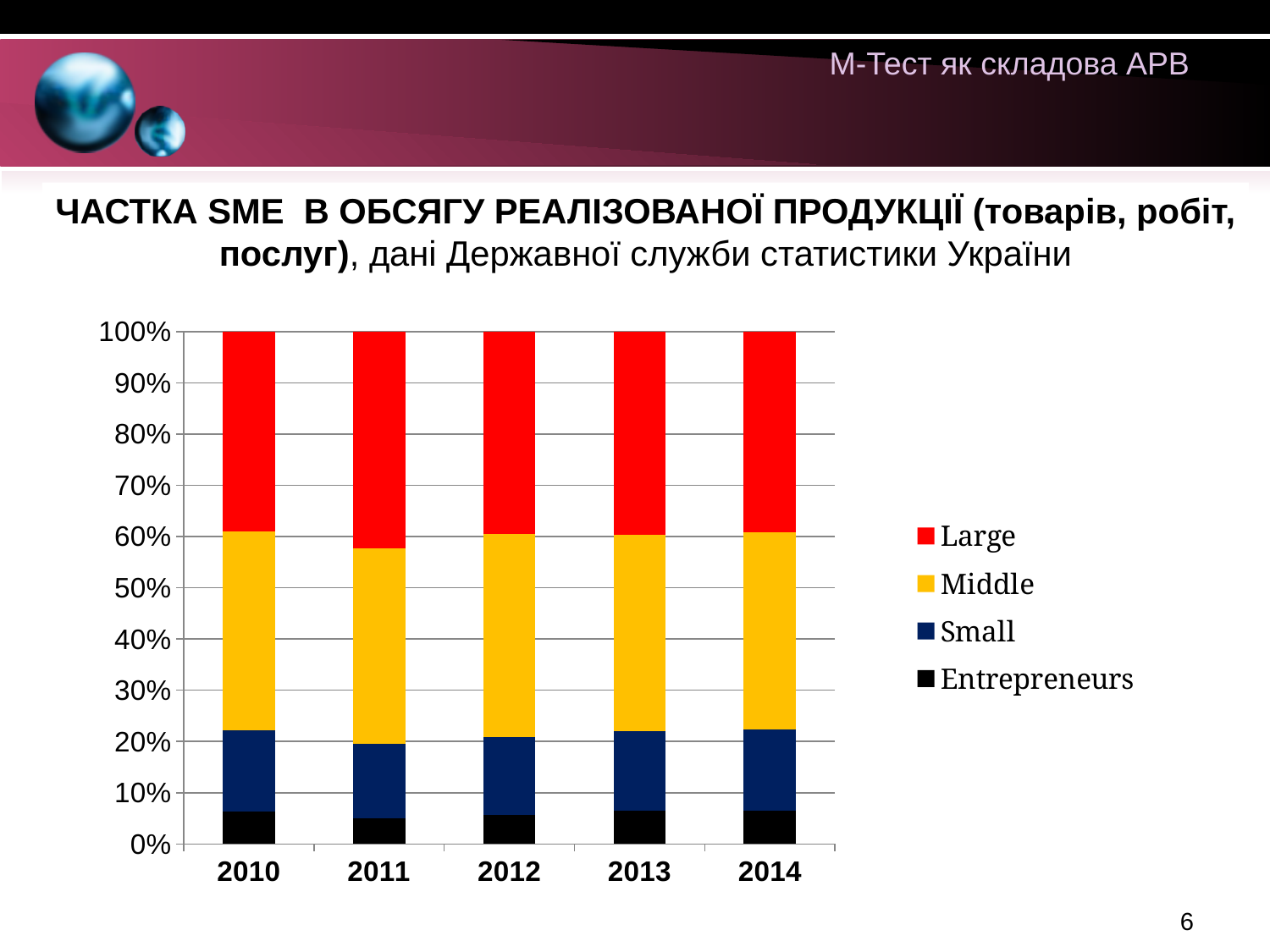
Is the share for Entrepreneurs in 2010 greater or less than 10%? less What kind of chart is shown on the slide? Stacked bar chart How many years are shown on the x axis of the chart? 5 Is the share for Large in 2011 greater or less than 40%? greater In 2014, which segment is larger: Small or Entrepreneurs? Small Which series is shown in red in the chart? Large Which series forms the bottom segment of each stacked bar? Entrepreneurs How many series does the chart legend list? 4 In which year does the top of the Middle segment reach the lowest point on the axis? 2011 Does the Large share rise or fall from 2011 to 2012? fall What is the total of the stacked bar for 2012? 100% In which year is the Large segment the tallest? 2011